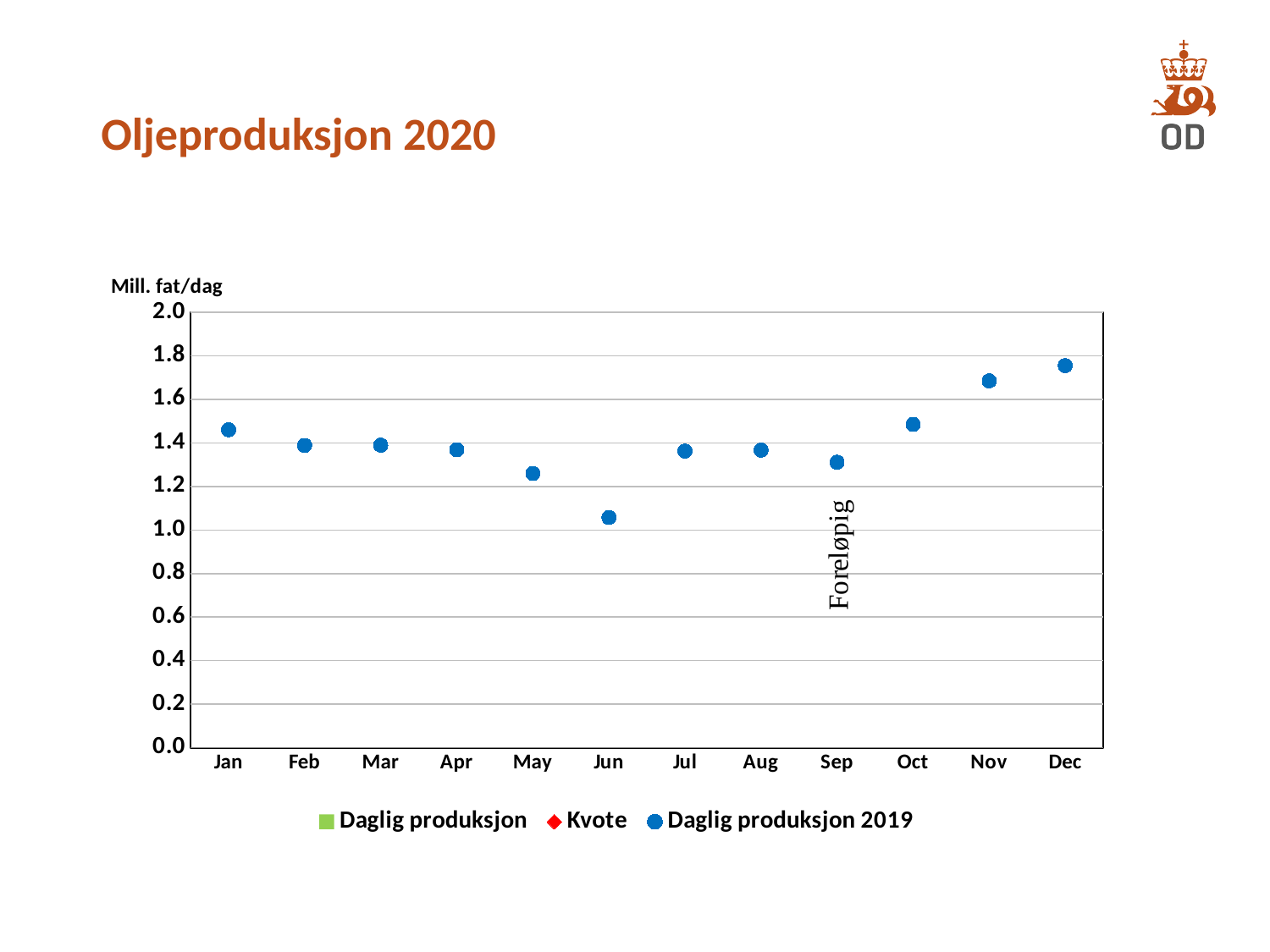
Do the values for Daglig produksjon 2019 rise or fall from Sep to Dec? rise Which month has the lowest value for Daglig produksjon 2019? Jun Which is larger for Daglig produksjon 2019: the value in May or the value in Jun? May Is the value for Daglig produksjon 2019 in Jan greater or less than 1.4? greater Is the value for Daglig produksjon 2019 in Nov greater or less than 1.6? greater How many series does the legend list? 3 What unit is shown on the y-axis label of the chart? Mill. fat/dag How many months are shown along the x axis? 12 Which month has the highest value for Daglig produksjon 2019? Dec Is the value for Daglig produksjon 2019 in Jun greater or less than 1.2? less Which is larger for Daglig produksjon 2019: the value in Oct or the value in Sep? Oct What is the title of the chart on the slide? Oljeproduksjon 2020